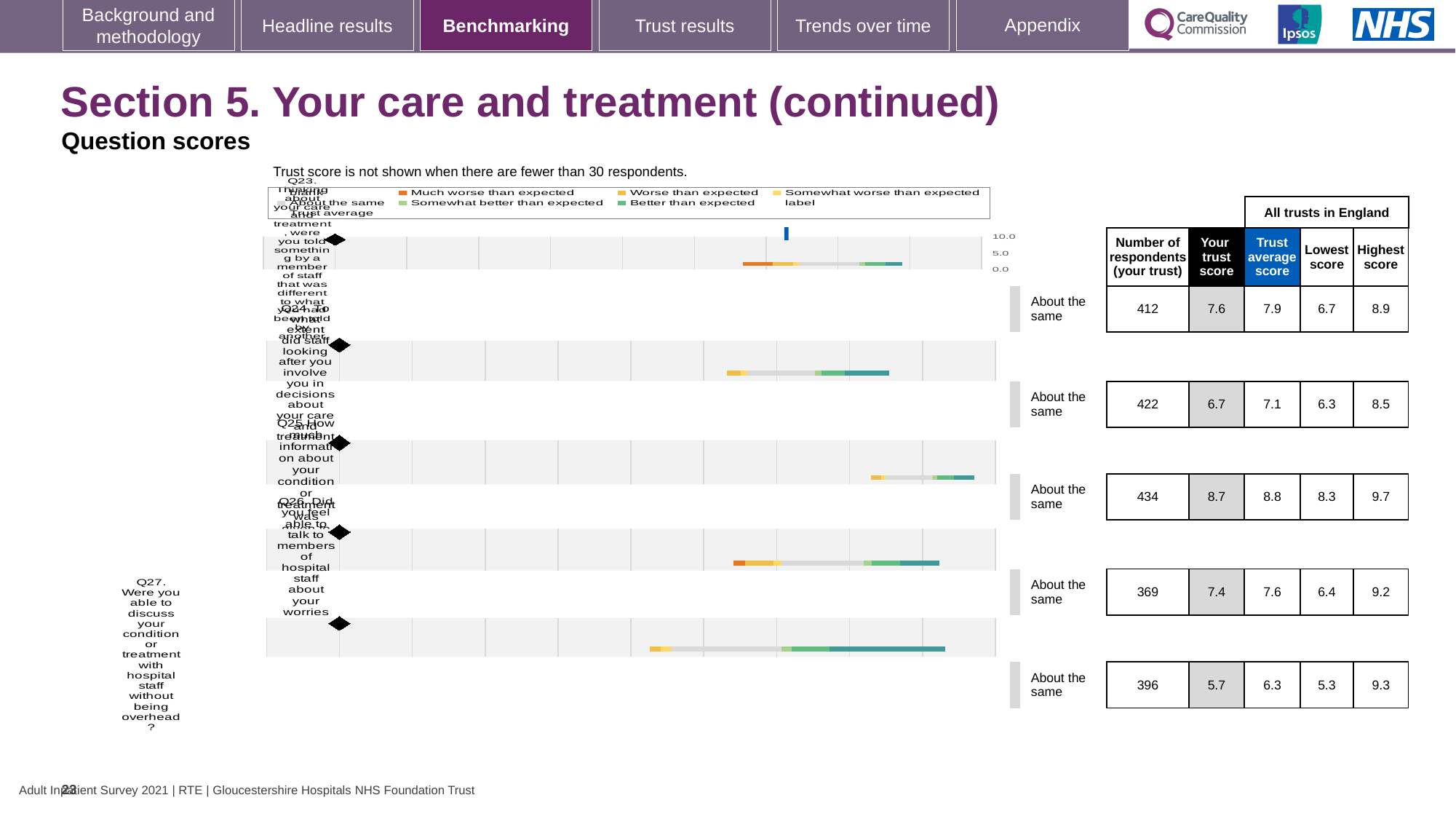
What is the 'Your trust score' for Q27? 5.7 How many questions (Q23 to Q27) are plotted in the chart? 5 What is the difference between the 'Your trust score' for Q25 and for Q27? 3.0 What is the number of respondents for Q25? 434 What kind of chart is used to show the question scores on this slide? bar chart What benchmark category is shown next to each of the five questions? About the same What is the highest score across all trusts in England for Q26? 9.2 Which question has the lowest 'Your trust score'? Q27 Which question has the highest 'Your trust score'? Q25 What is the 'Your trust score' for Q23? 7.6 What is the trust average score for Q24? 7.1 For Q23, which is larger: the 'Your trust score' or the trust average score? Trust average score